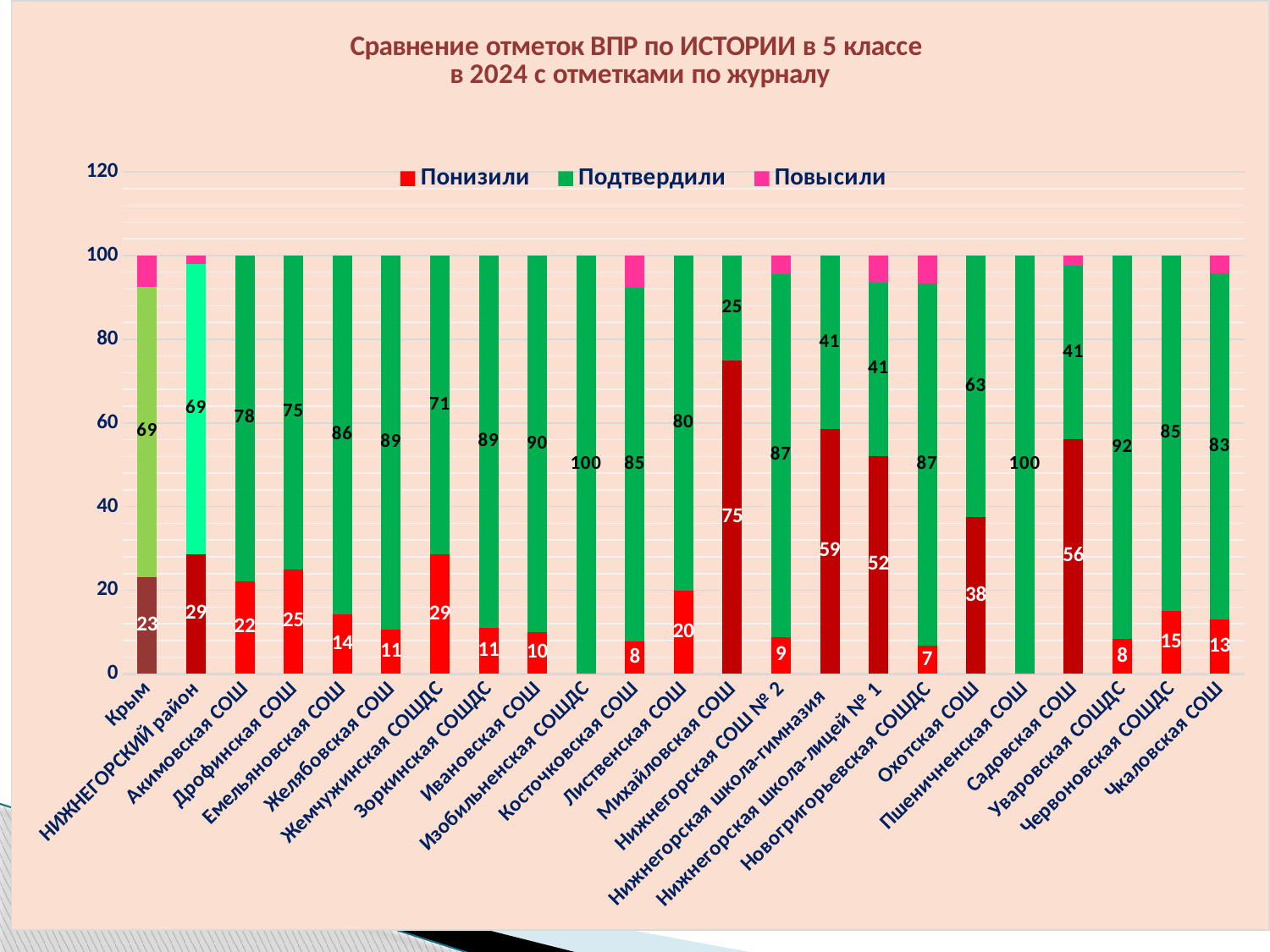
What is the difference between the Понизили values for НИЖНЕГОРСКИЙ район and Крым? 6 What is the value of Понизили for Михайловская СОШ? 75 Which category has the lowest value for Подтвердили? Михайловская СОШ How many series does the legend list? 3 What is the difference between the Подтвердили values for Акимовская СОШ and Дрофинская СОШ? 3 Which category has the highest value for Понизили? Михайловская СОШ What are the three series named in the legend? Понизили, Подтвердили, Повысили How many categories are shown along the x axis? 23 Which has the larger Понизили value, Охотская СОШ or Садовская СОШ? Садовская СОШ What is the value of Подтвердили for Уваровская СОШДС? 92 What kind of chart is shown on the slide? Stacked bar chart What is the value of Понизили for Крым? 23